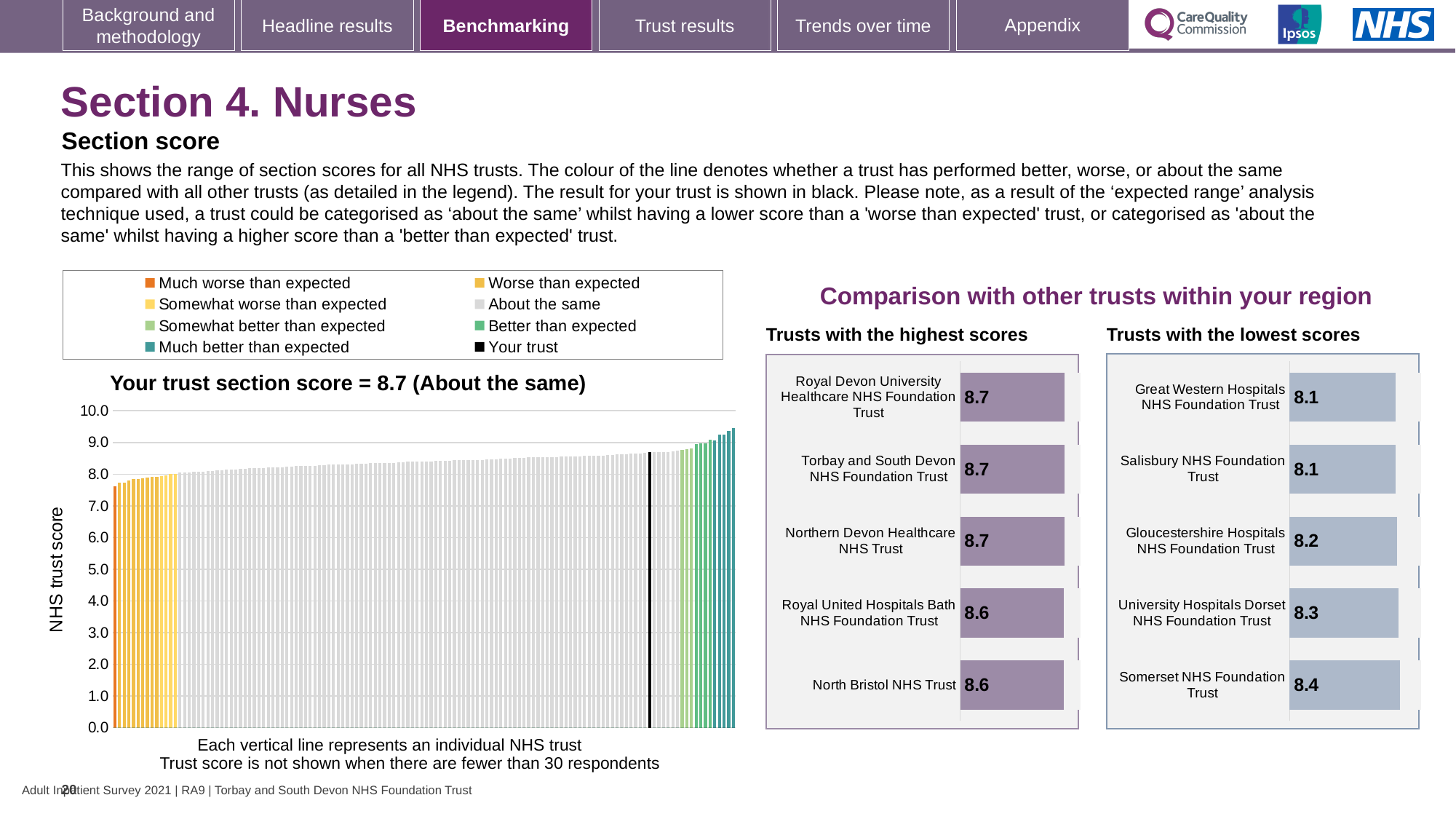
How many entries does the legend of the main section score chart on the left list? 8 In the 'Trusts with the lowest scores' chart, which trust has the highest score? Somerset NHS Foundation Trust In the 'Trusts with the highest scores' chart, what is the difference between the scores of Royal Devon University Healthcare NHS Foundation Trust and North Bristol NHS Trust? 0.1 In the 'Trusts with the highest scores' chart, what is the score for Royal Devon University Healthcare NHS Foundation Trust? 8.7 How many trusts are shown in the 'Trusts with the highest scores' chart? 5 In the main section score chart on the left, what is your trust's section score and category? 8.7 (About the same) In the 'Trusts with the lowest scores' chart, which has the larger score: Somerset NHS Foundation Trust or Gloucestershire Hospitals NHS Foundation Trust? Somerset NHS Foundation Trust In the 'Trusts with the highest scores' chart, what is the score for North Bristol NHS Trust? 8.6 In the 'Trusts with the lowest scores' chart, what is the difference between the scores of Somerset NHS Foundation Trust and Great Western Hospitals NHS Foundation Trust? 0.3 In the 'Trusts with the lowest scores' chart, what is the score for Somerset NHS Foundation Trust? 8.4 In the 'Trusts with the lowest scores' chart, what is the score for Gloucestershire Hospitals NHS Foundation Trust? 8.2 What kind of chart is the 'Trusts with the lowest scores' chart? Bar chart